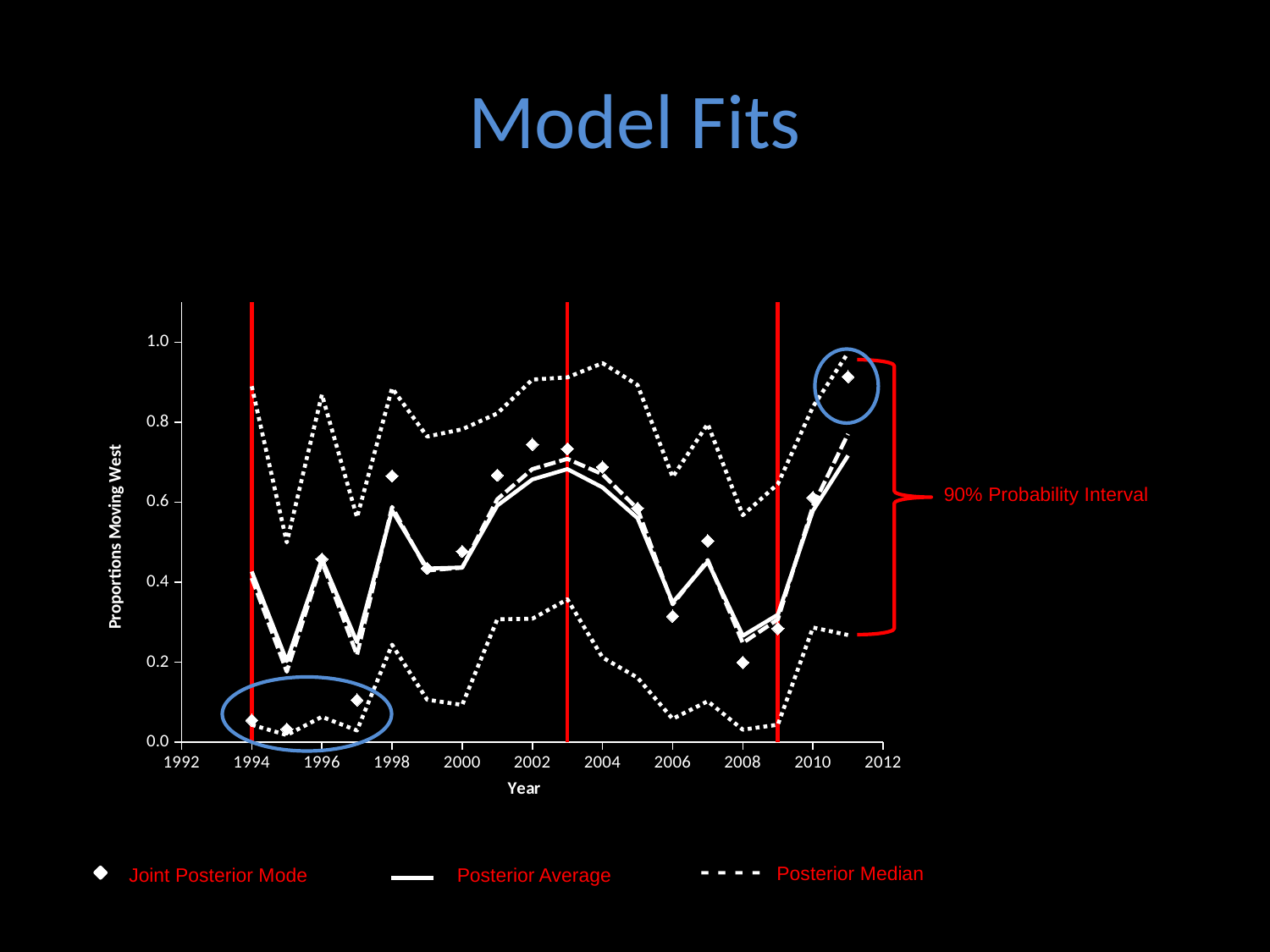
Which year has the larger Joint Posterior Mode value, 2002 or 2006? 2002 Is the Joint Posterior Mode value for 2002 greater or less than 0.6? greater How many series does the legend list? 3 Is the Joint Posterior Mode value for 2011 greater or less than 0.8? greater What does the red brace on the right of the chart label? 90% Probability Interval What kind of chart is shown on the slide? line chart What is the title of the chart? Model Fits Does the Posterior Average rise or fall from 2009 to 2011? rise Does the Posterior Average rise or fall from 2003 to 2006? fall Is the Joint Posterior Mode value for 1994 greater or less than 0.2? less In which year is the Joint Posterior Mode highest? 2011